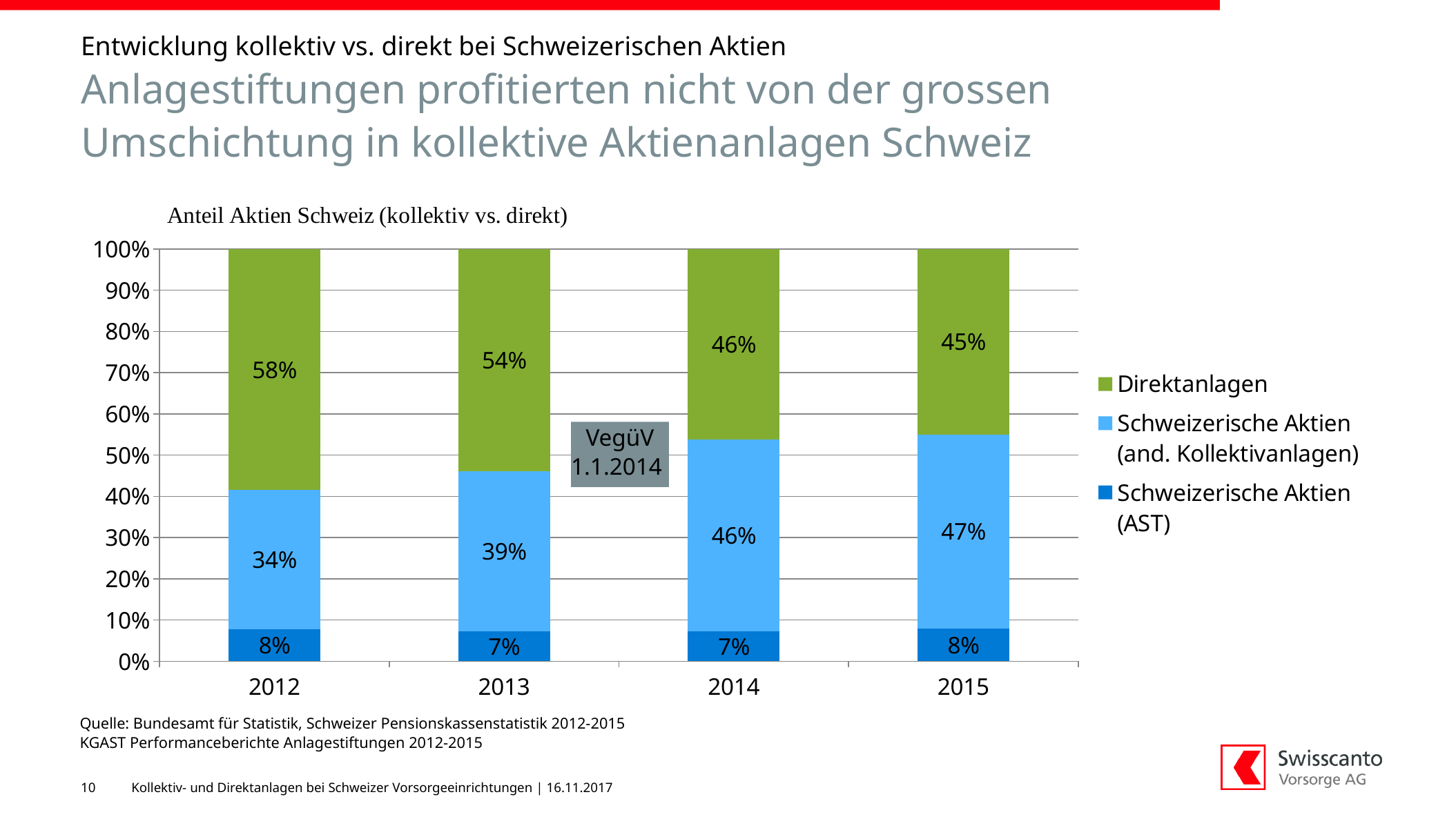
What is the value for Direktanlagen in 2012? 58% In which year is the Schweizerische Aktien (and. Kollektivanlagen) share lowest? 2012 In which year is the Direktanlagen share highest? 2012 What is the difference between the Direktanlagen share in 2012 and in 2015? 13 percentage points What is the value for Schweizerische Aktien (AST) in 2013? 7% What is the title of the chart? Anteil Aktien Schweiz (kollektiv vs. direkt) What is the value for Schweizerische Aktien (and. Kollektivanlagen) in 2014? 46% How many years are shown on the x axis? 4 Does the Direktanlagen share rise or fall from 2012 to 2015? Fall How many series does the legend list? 3 What kind of chart is shown? Stacked bar chart Which is larger in 2013: Direktanlagen or Schweizerische Aktien (and. Kollektivanlagen)? Direktanlagen